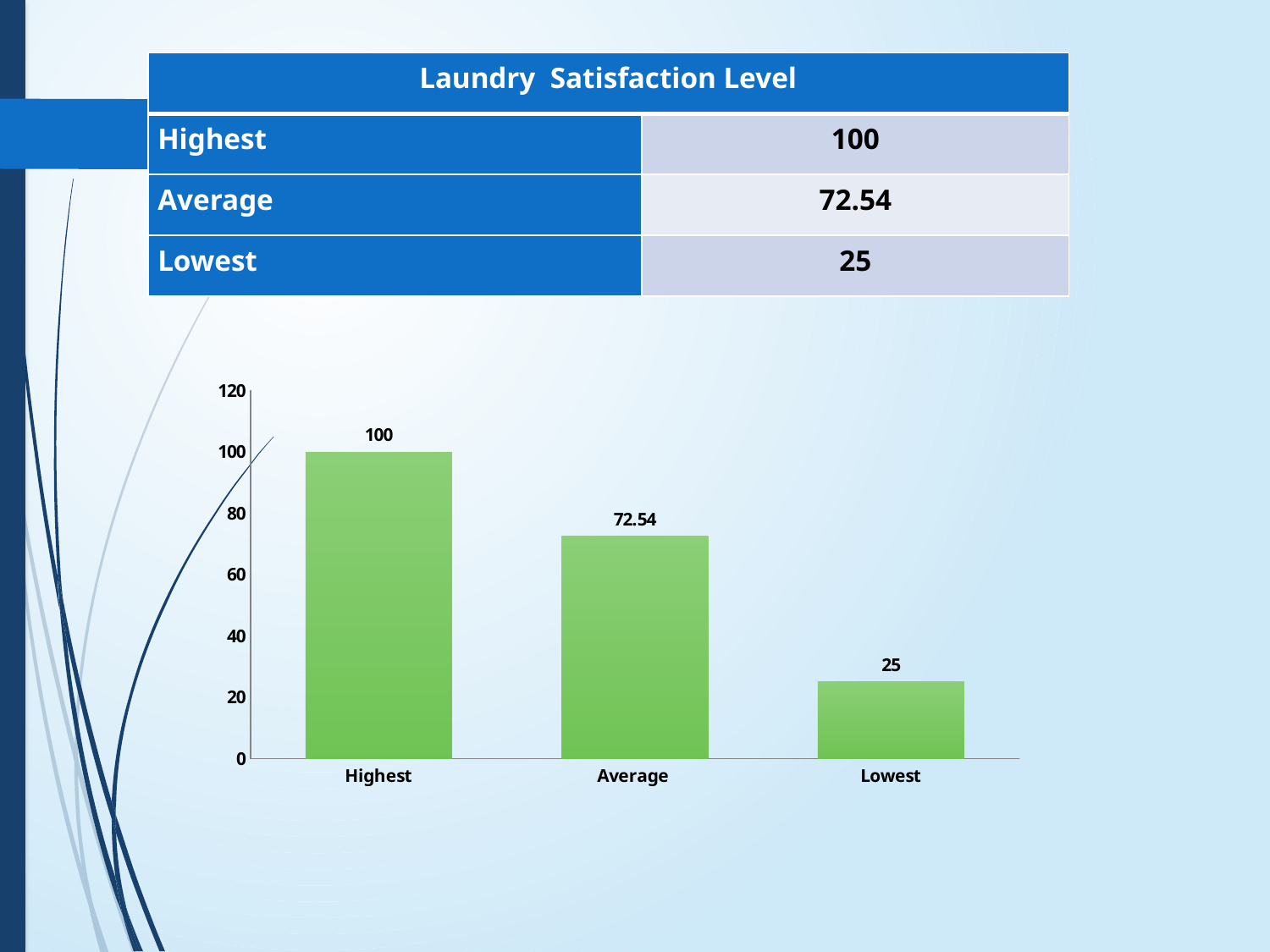
Is the value for Average greater or less than 80? less What is the value of the Average bar? 72.54 Which category has the shortest bar? Lowest Do the bar values rise or fall from left to right along the x axis? fall How many categories are shown on the x axis? 3 Which category has the tallest bar? Highest What is the value of the Highest bar? 100 What is the difference between the Highest and Average values? 27.46 What is the difference between the Highest and Lowest values? 75 Which is larger, the Average value or the Lowest value? Average What is the value of the Lowest bar? 25 What kind of chart is shown on the slide? bar chart